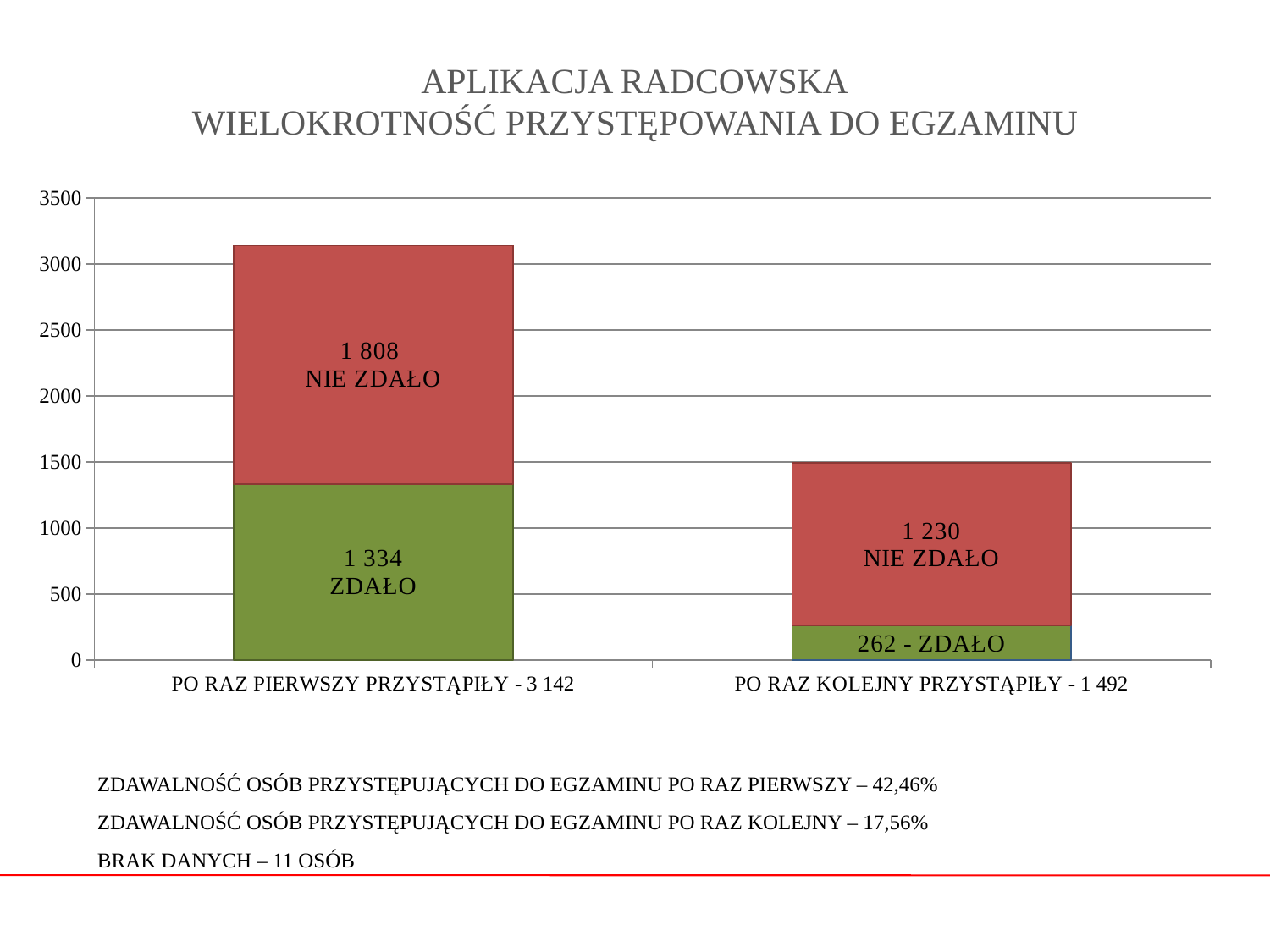
What is the total of the stacked bar for PO RAZ PIERWSZY PRZYSTĄPIŁY? 3 142 Which colour represents NIE ZDAŁO (failed) in the chart? Red Which category has the taller stacked bar? PO RAZ PIERWSZY PRZYSTĄPIŁY What is the difference between the number who failed and the number who passed among first-time takers (PO RAZ PIERWSZY PRZYSTĄPIŁY)? 474 What kind of chart is shown on the slide? Stacked bar chart Which is larger: the number who passed among first-time takers (1 334) or the number who failed among repeat takers (1 230)? 1 334 (first-time takers who passed) How many people failed (NIE ZDAŁO) among those who took the exam again (PO RAZ KOLEJNY PRZYSTĄPIŁY)? 1 230 What is the total of the stacked bar for PO RAZ KOLEJNY PRZYSTĄPIŁY? 1 492 How many people failed (NIE ZDAŁO) among those who took the exam for the first time (PO RAZ PIERWSZY PRZYSTĄPIŁY)? 1 808 How many people passed (ZDAŁO) among those who took the exam for the first time (PO RAZ PIERWSZY PRZYSTĄPIŁY)? 1 334 How many categories are shown on the x axis? 2 How many people passed (ZDAŁO) among those who took the exam again (PO RAZ KOLEJNY PRZYSTĄPIŁY)? 262